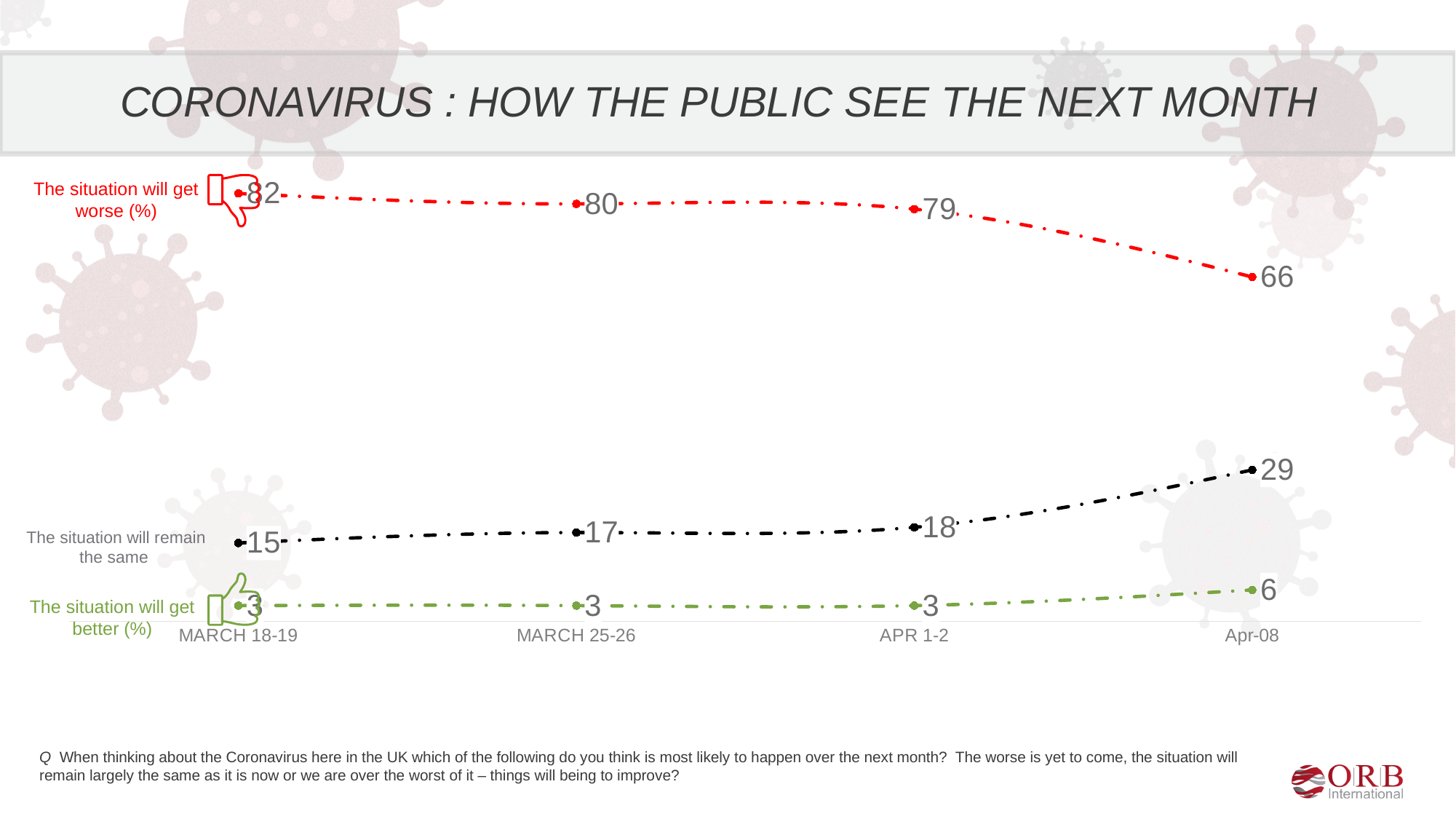
What is the difference between the 'will remain the same' values on APR 1-2 and Apr-08? 11 What is the difference between the 'will get worse' values on APR 1-2 and Apr-08? 13 At which date is the value for 'The situation will remain the same' highest? Apr-08 Does the 'The situation will remain the same' series rise or fall from MARCH 18-19 to Apr-08? rise What kind of chart is shown on the slide? line chart What value is shown for 'The situation will get better (%)' on APR 1-2? 3 What percentage of the public thought the situation will get worse on Apr-08? 66 What value is shown for 'The situation will remain the same' on MARCH 25-26? 17 What value is shown for 'The situation will get worse (%)' on MARCH 18-19? 82 At which date is the value for 'The situation will get worse (%)' lowest? Apr-08 How many series are plotted on the chart? 3 How many dates are shown on the x axis? 4